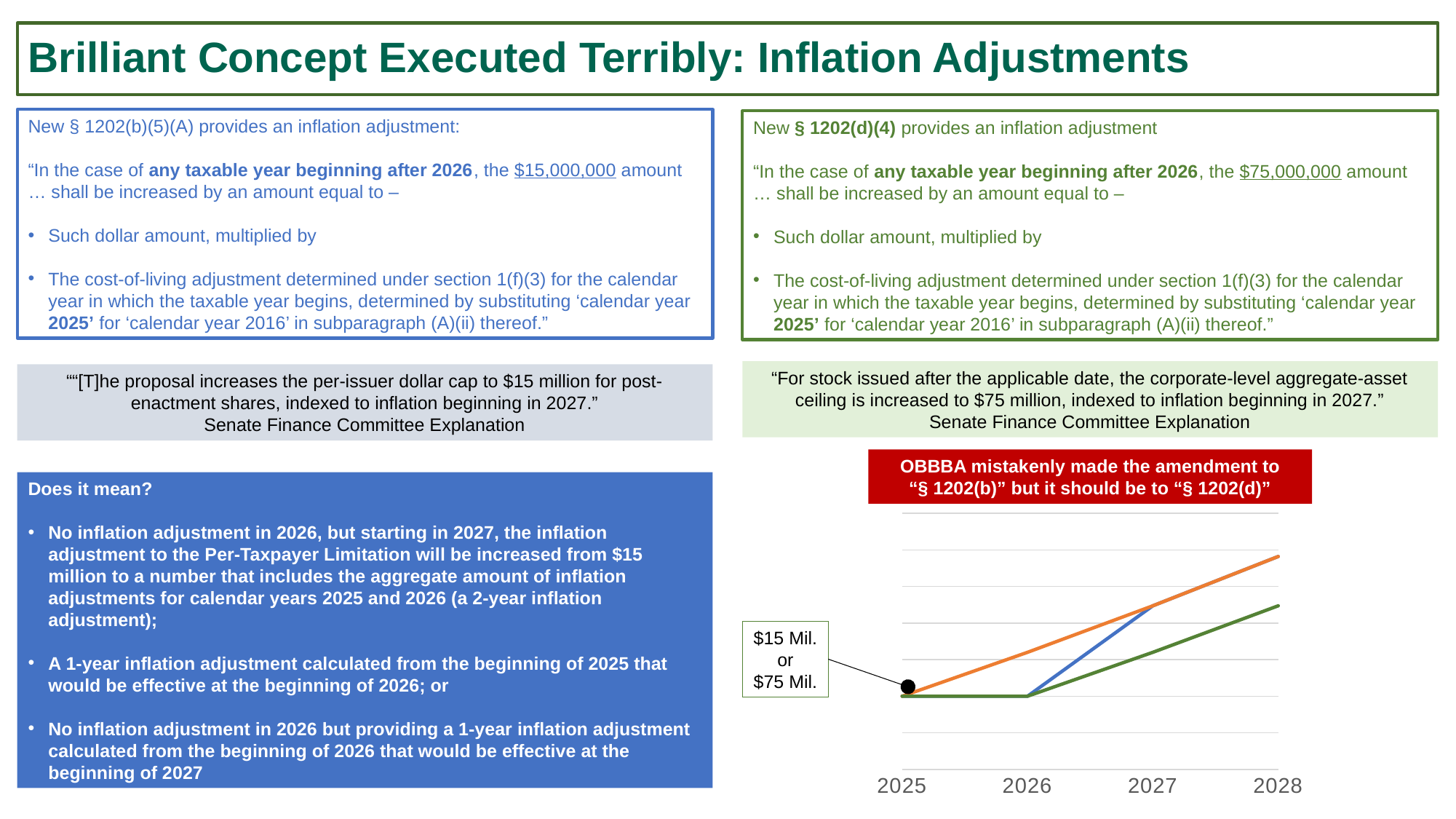
Does the orange line rise or fall from 2025 to 2028 on the line chart? Rise What does the callout label attached to the 2025 point on the line chart say? $15 Mil. or $75 Mil. How many lines are plotted on the line chart? 3 Between 2025 and 2026, does the green line rise, fall, or stay flat on the line chart? Stay flat How many years are labeled on the x axis of the line chart? 4 What is the first year shown on the x axis of the line chart? 2025 Which colored line reaches the highest point at 2028 on the line chart? Orange At 2028, is the orange line or the green line higher on the line chart? Orange Which colored line is lowest at 2028 on the line chart? Green What kind of chart is shown at the bottom right of the slide? Line chart In which year does the blue line begin to rise on the line chart? 2026 What is the last year shown on the x axis of the line chart? 2028